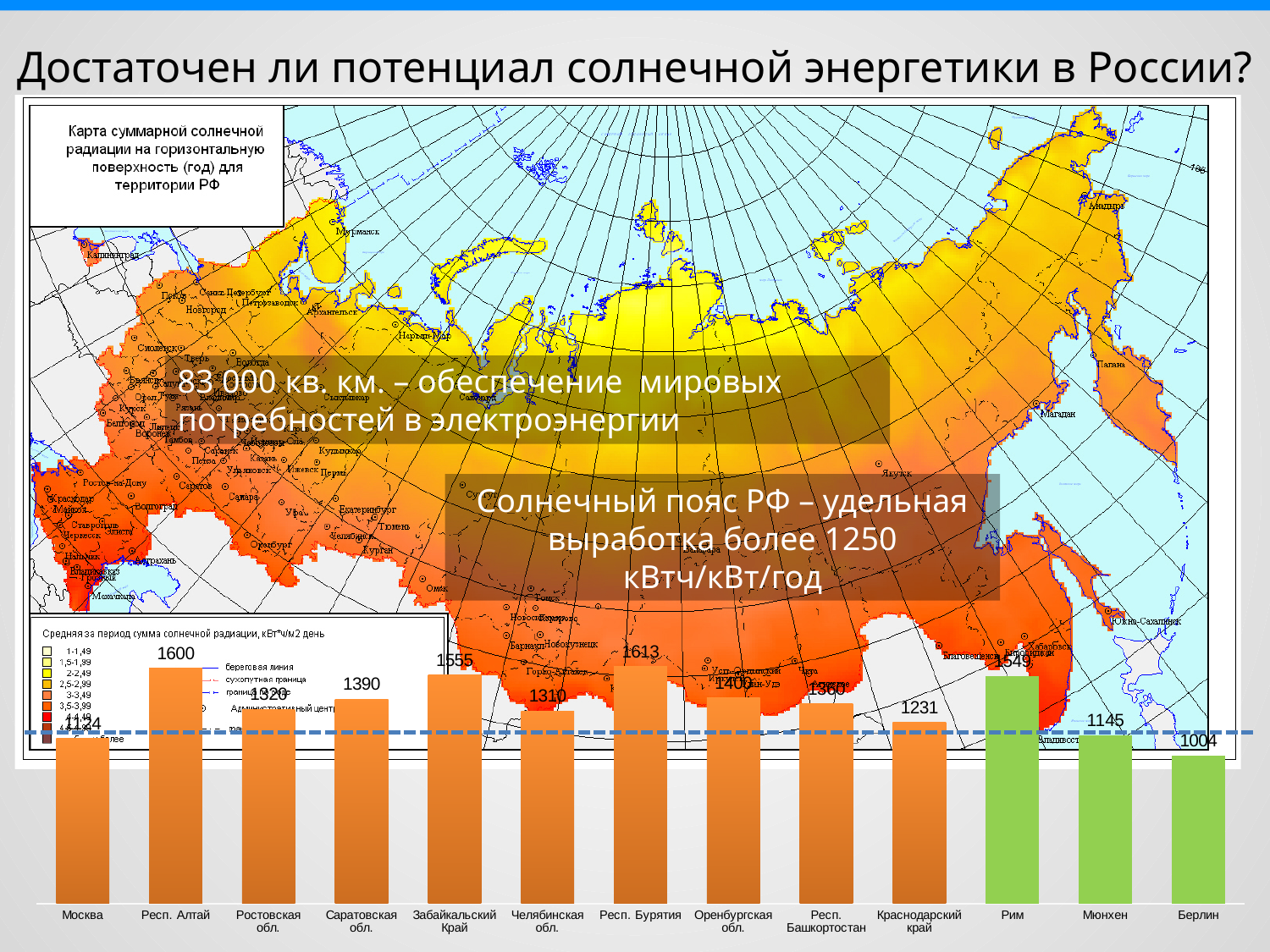
Which is larger, the value for Мюнхен or the value for Берлин? Мюнхен How many categories are shown in the bar chart? 13 Which category has the lowest value? Берлин What is the value for Краснодарский край? 1231 Which category has the highest value? Респ. Бурятия What is the value for Берлин? 1004 What is the difference between the values for Респ. Алтай and Берлин? 596 What kind of chart is shown at the bottom of the slide? Bar chart What is the value for Саратовская обл.? 1390 What is the value for Респ. Бурятия? 1613 What is the value for Респ. Алтай? 1600 What is the difference between the values for Саратовская обл. and Челябинская обл.? 80